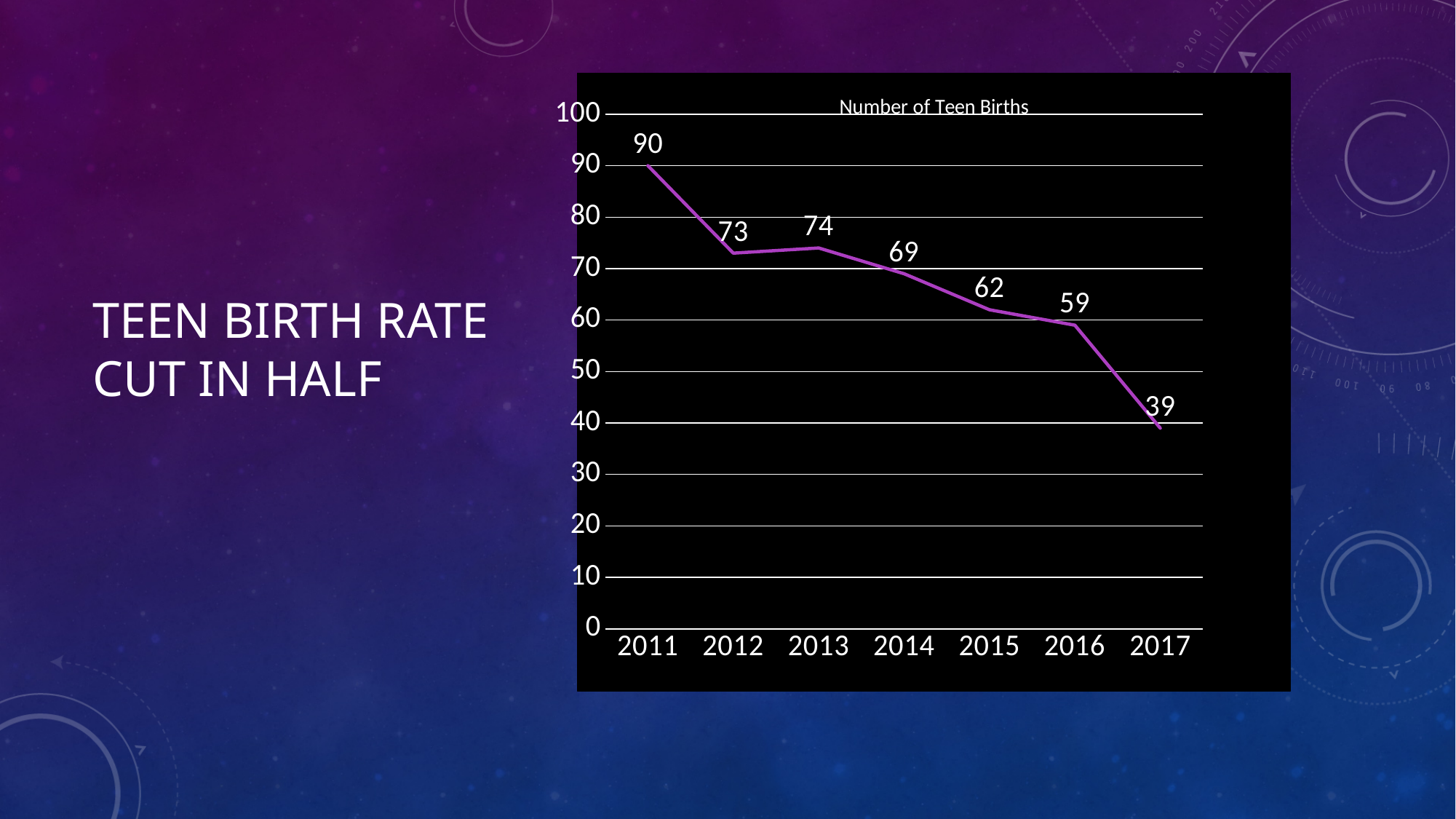
Do the values generally rise or fall from 2011 to 2017? fall Which year has more teen births, 2012 or 2013? 2013 What is the title of the chart? Number of Teen Births What is the number of teen births in 2014? 69 What is the number of teen births in 2011? 90 How many years are plotted on the chart? 7 Is the value for 2016 greater or less than 50? greater Which year has the highest number of teen births? 2011 What kind of chart is shown on the slide? line chart What is the number of teen births in 2017? 39 What is the difference between the number of teen births in 2011 and 2017? 51 Which year has the lowest number of teen births? 2017